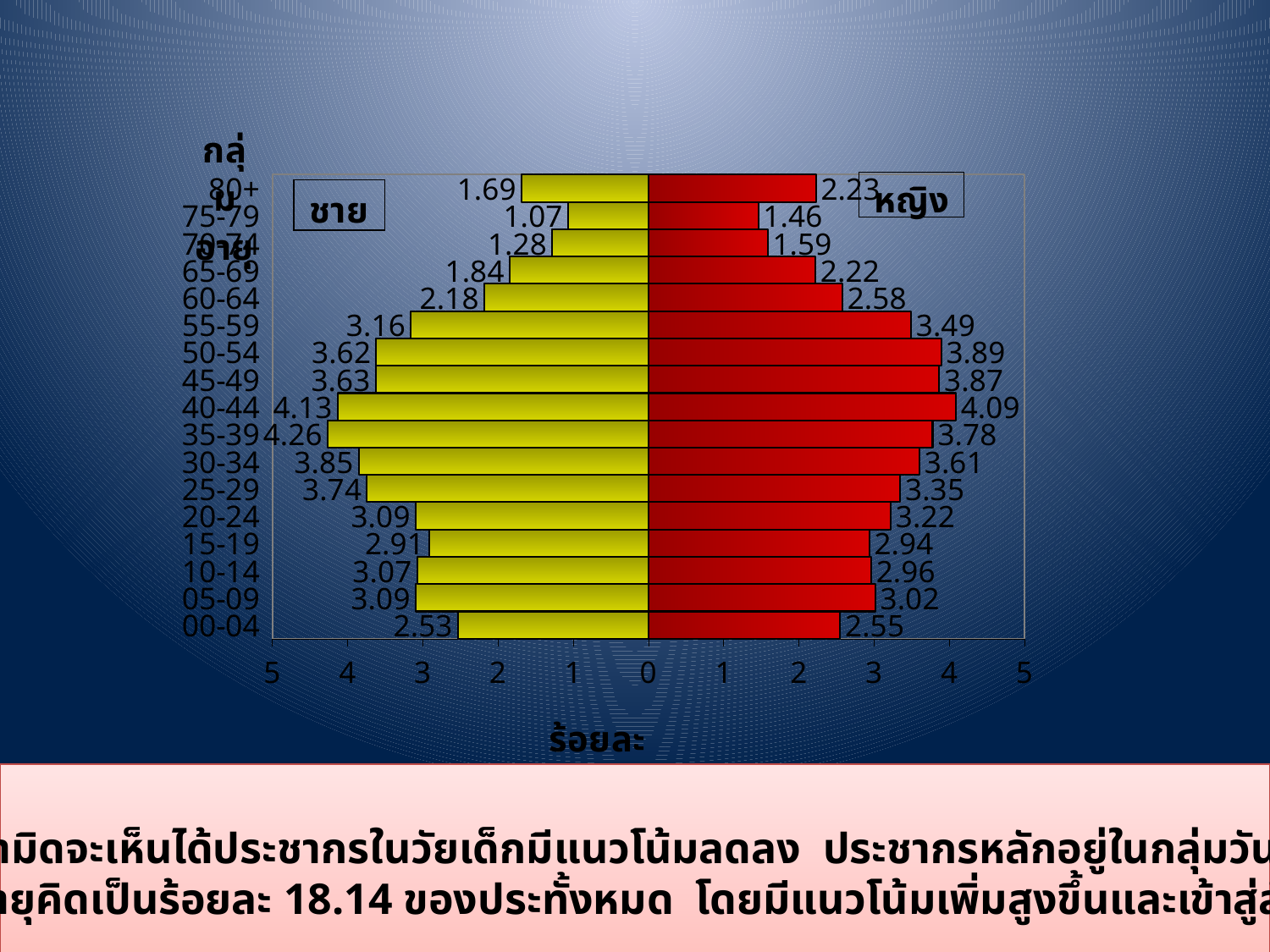
What kind of chart is shown on the slide? Bar chart (population pyramid) How many series does the chart show? 2 Which age group has the lowest value for males (ชาย)? 75-79 In the 35-39 age group, which is larger: the male (ชาย) value or the female (หญิง) value? ชาย (male) What is the label on the horizontal axis of the chart? ร้อยละ Which age group has the highest value for males (ชาย)? 35-39 What is the value for females (หญิง) in the 80+ age group? 2.23 What is the difference between the female (หญิง) and male (ชาย) values in the 80+ age group? 0.54 What is the value for females (หญิง) in the 00-04 age group? 2.55 What is the value for males (ชาย) in the 35-39 age group? 4.26 Which age group has the highest value for females (หญิง)? 40-44 How many age groups are shown on the chart? 17